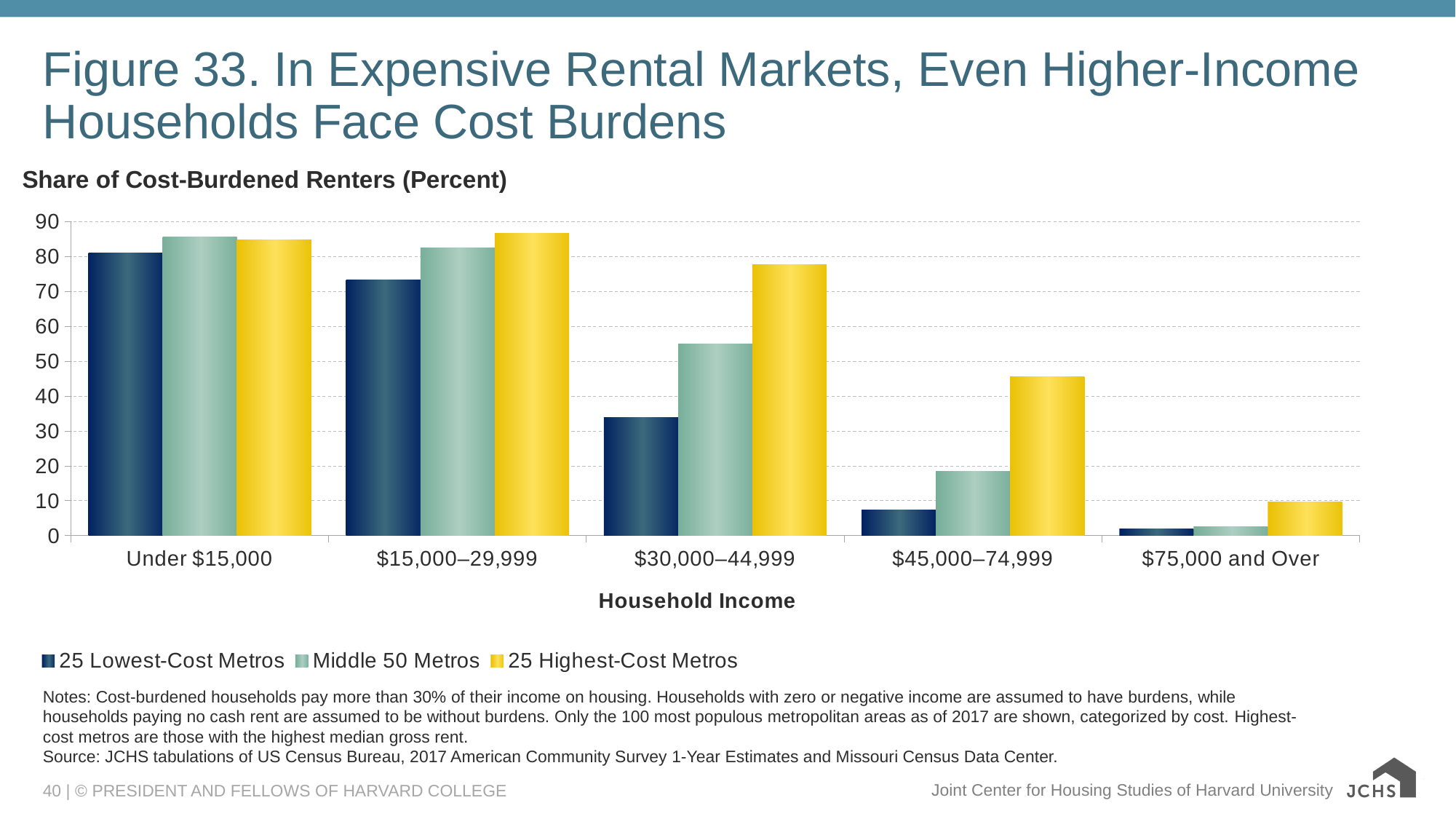
Is the value for Middle 50 Metros in the $45,000–74,999 category greater or less than 10? greater Is the value for 25 Highest-Cost Metros in the $30,000–44,999 category greater or less than 70? greater How many household income categories are shown on the x axis? 5 Do the values for 25 Lowest-Cost Metros rise or fall as household income increases along the x axis? Fall What colour represents 25 Highest-Cost Metros in the legend? Yellow In the $45,000–74,999 category, which is larger: Middle 50 Metros or 25 Highest-Cost Metros? 25 Highest-Cost Metros Which series has the lowest value in the $30,000–44,999 category? 25 Lowest-Cost Metros How many series does the legend list? 3 Is the value for 25 Lowest-Cost Metros in the $30,000–44,999 category greater or less than 40? less Which household income category has the lowest value for 25 Highest-Cost Metros? $75,000 and Over What kind of chart is shown on the slide? Bar chart What is the title of the x axis? Household Income